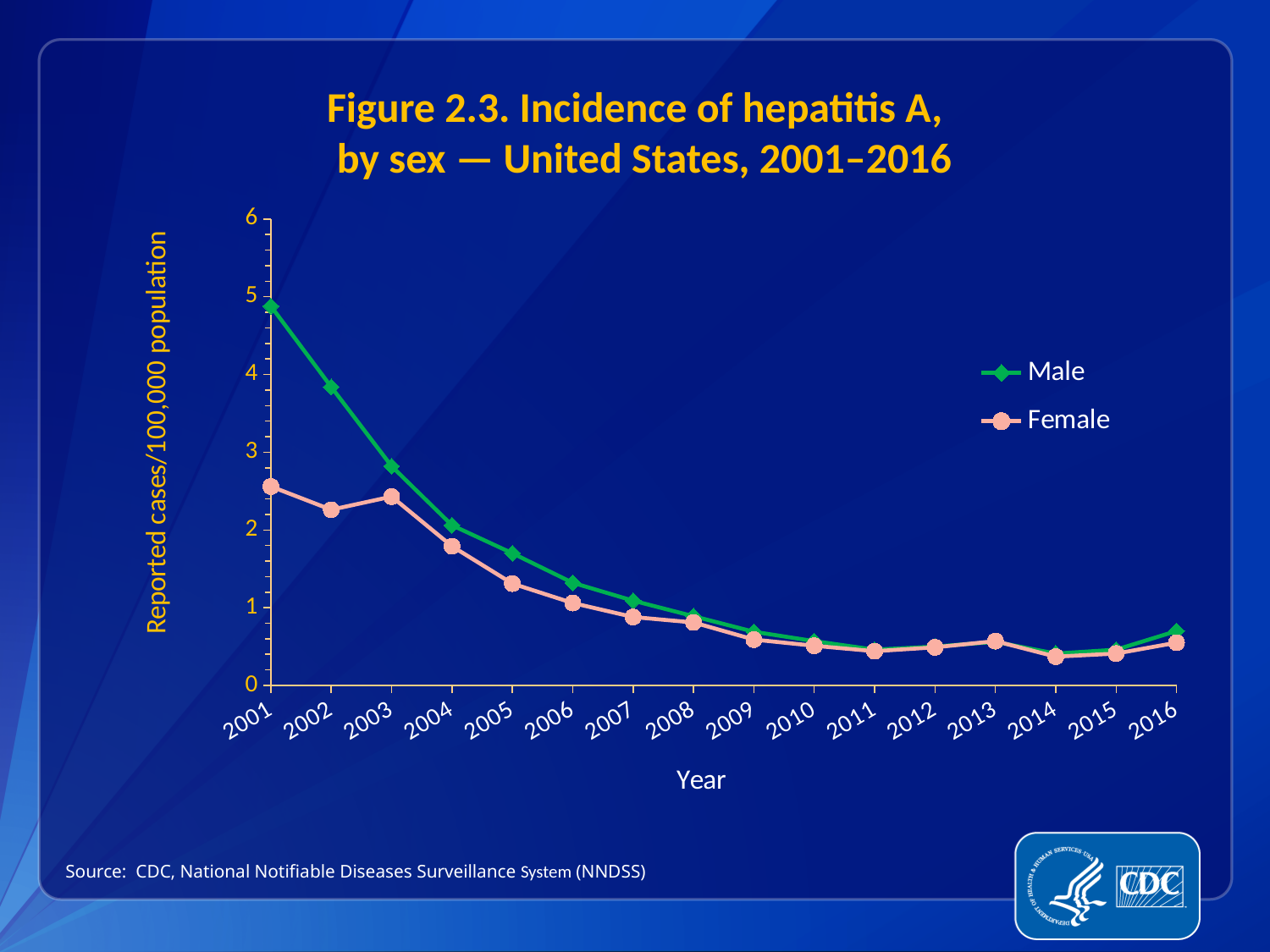
Is the Male value for 2001 greater or less than 4? greater How many series does the legend list? 2 What kind of chart is shown on the slide? line chart What is the label of the y axis? Reported cases/100,000 population How many years are plotted along the x axis? 16 Is the Female value for 2001 greater or less than 2? greater In 2003, which series has the higher value, Male or Female? Male In which year is the Male incidence rate highest? 2001 Is the Female value for 2004 greater or less than 2? less Does the Male incidence rate rise or fall from 2001 to 2010? fall